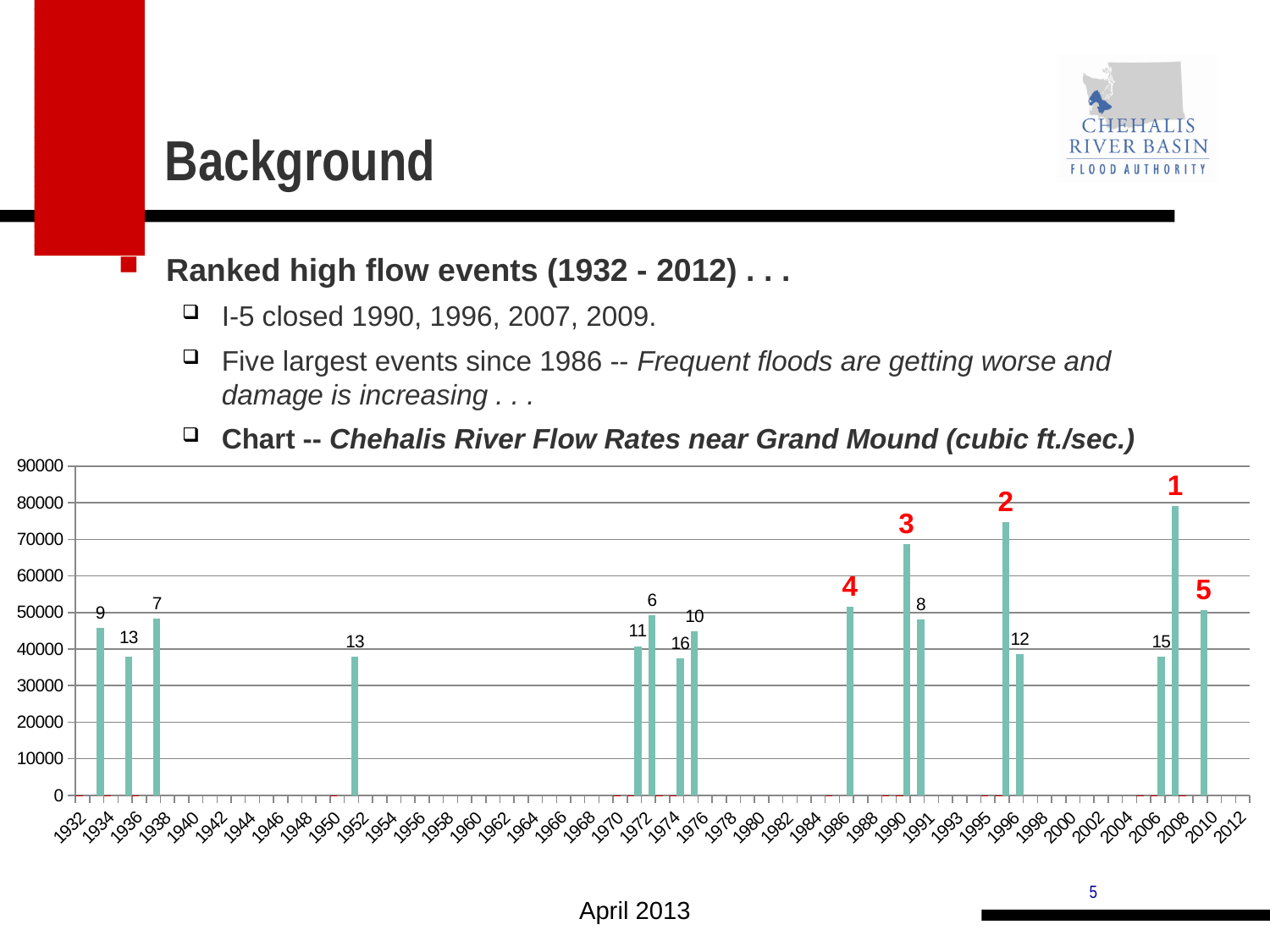
Which is larger, the bar labelled 1 or the bar labelled 2? the bar labelled 1 What kind of chart is shown on the slide? bar chart Is the value of the bar labelled 5 greater or less than 40000? greater What is the title of the chart as given in the bullet text? Chehalis River Flow Rates near Grand Mound (cubic ft./sec.) Is the value of the bar labelled 2 greater or less than 70000? greater Is the value of the bar labelled 1 greater or less than 70000? greater What is the highest value shown on the chart's vertical axis? 90000 Which is larger, the bar labelled 3 or the bar labelled 4? the bar labelled 3 Which rank label is shown above the tallest bar in the chart? 1